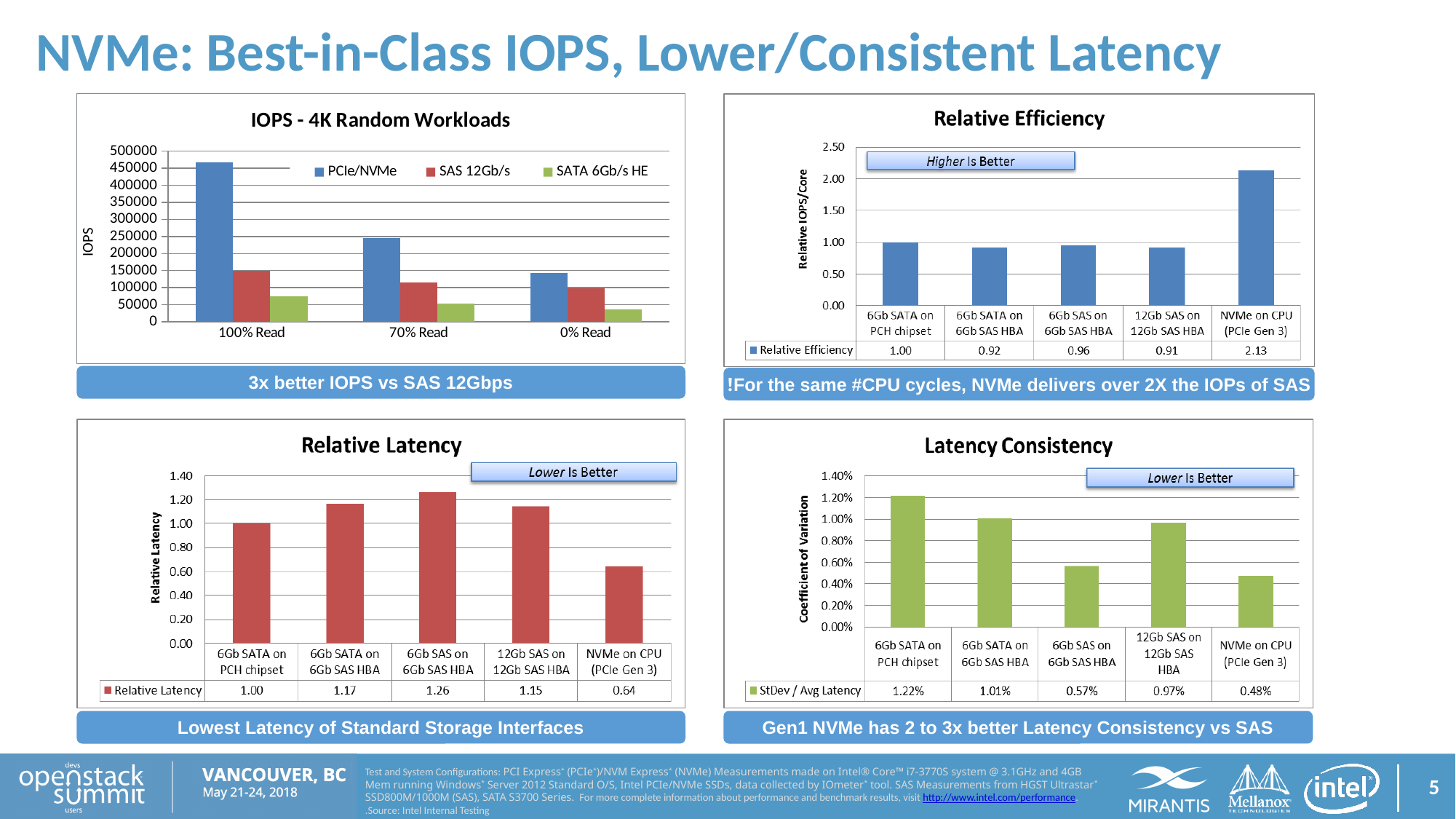
In the Relative Latency chart, which category has the lowest relative latency? NVMe on CPU (PCIe Gen 3) In the IOPS - 4K Random Workloads chart, how does the PCIe/NVMe value change from 100% Read to 0% Read? It falls In the Latency Consistency chart, what is the StDev / Avg Latency value for 6Gb SATA on PCH chipset? 1.22% In the Relative Latency chart, what is the difference between the values for 6Gb SATA on 6Gb SAS HBA and NVMe on CPU (PCIe Gen 3)? 0.53 What kind of chart is the Relative Efficiency chart? Bar chart In the Latency Consistency chart, which is larger: the value for 6Gb SAS on 6Gb SAS HBA or the value for 12Gb SAS on 12Gb SAS HBA? 12Gb SAS on 12Gb SAS HBA In the Latency Consistency chart, which category has the highest coefficient of variation? 6Gb SATA on PCH chipset In the IOPS - 4K Random Workloads chart, how many series does the legend list? 3 In the Relative Efficiency chart, which category has the lowest value? 12Gb SAS on 12Gb SAS HBA In the Relative Efficiency chart, what is the value for NVMe on CPU (PCIe Gen 3)? 2.13 In the IOPS - 4K Random Workloads chart, is the PCIe/NVMe value for 100% Read greater or less than 400000? greater In the Relative Latency chart, what is the value for 6Gb SAS on 6Gb SAS HBA? 1.26